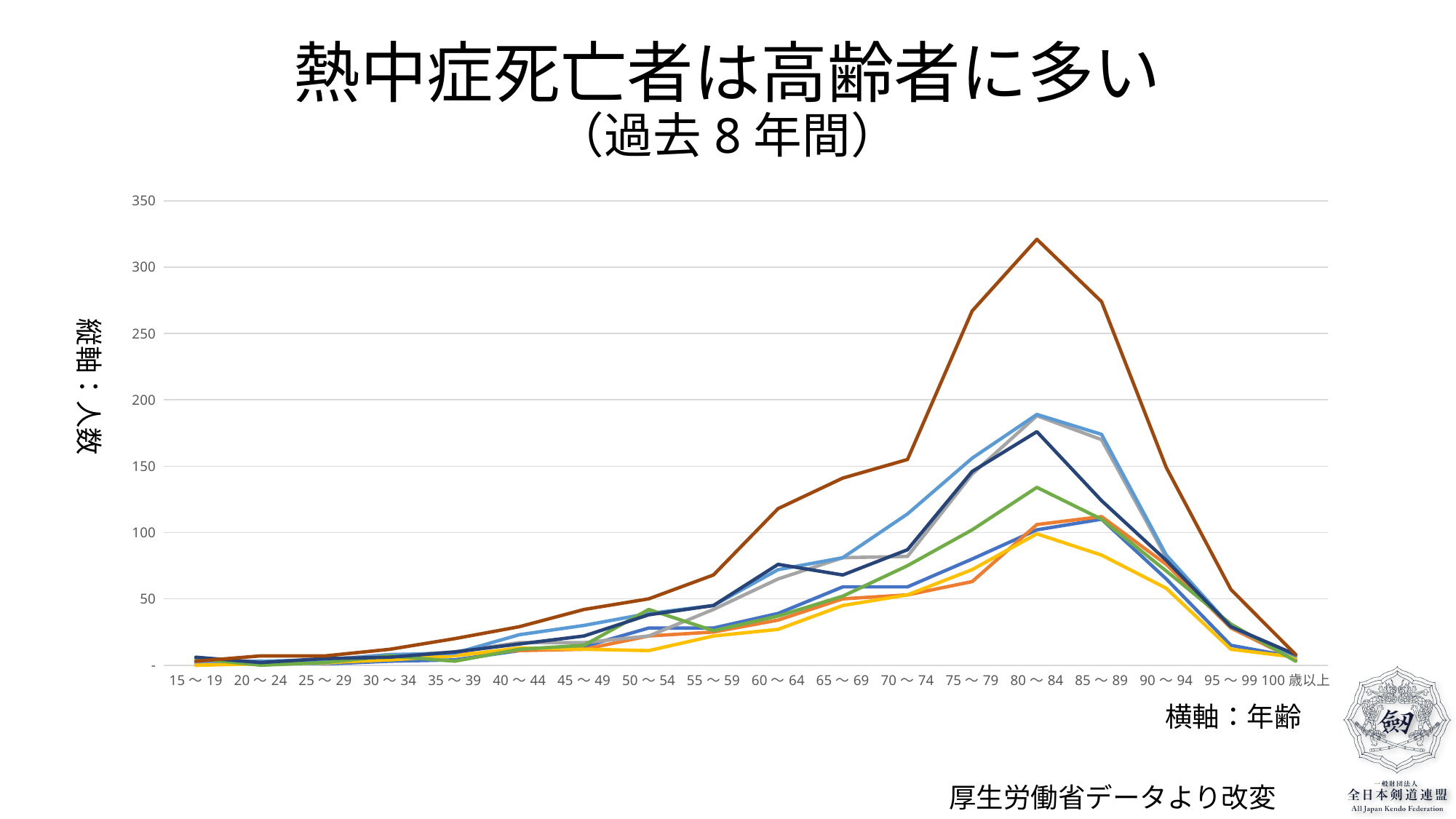
How many age categories are shown along the x axis? 18 What kind of chart is shown on the slide? line chart At which age category does the highest (brown) line reach its peak? 80〜84 Is the value of the brown line at 60〜64 greater or less than 100? greater Is the value of the brown line at 80〜84 greater or less than 300? greater Do the lines rise or fall along the x axis from 80〜84 to 100歳以上? fall Is the value of the brown line at 75〜79 greater or less than 250? greater Do the lines generally rise or fall along the x axis from 15〜19 to 80〜84? rise What does the vertical axis represent according to the slide? 人数 What is the title of the chart on the slide? 熱中症死亡者は高齢者に多い（過去8年間）